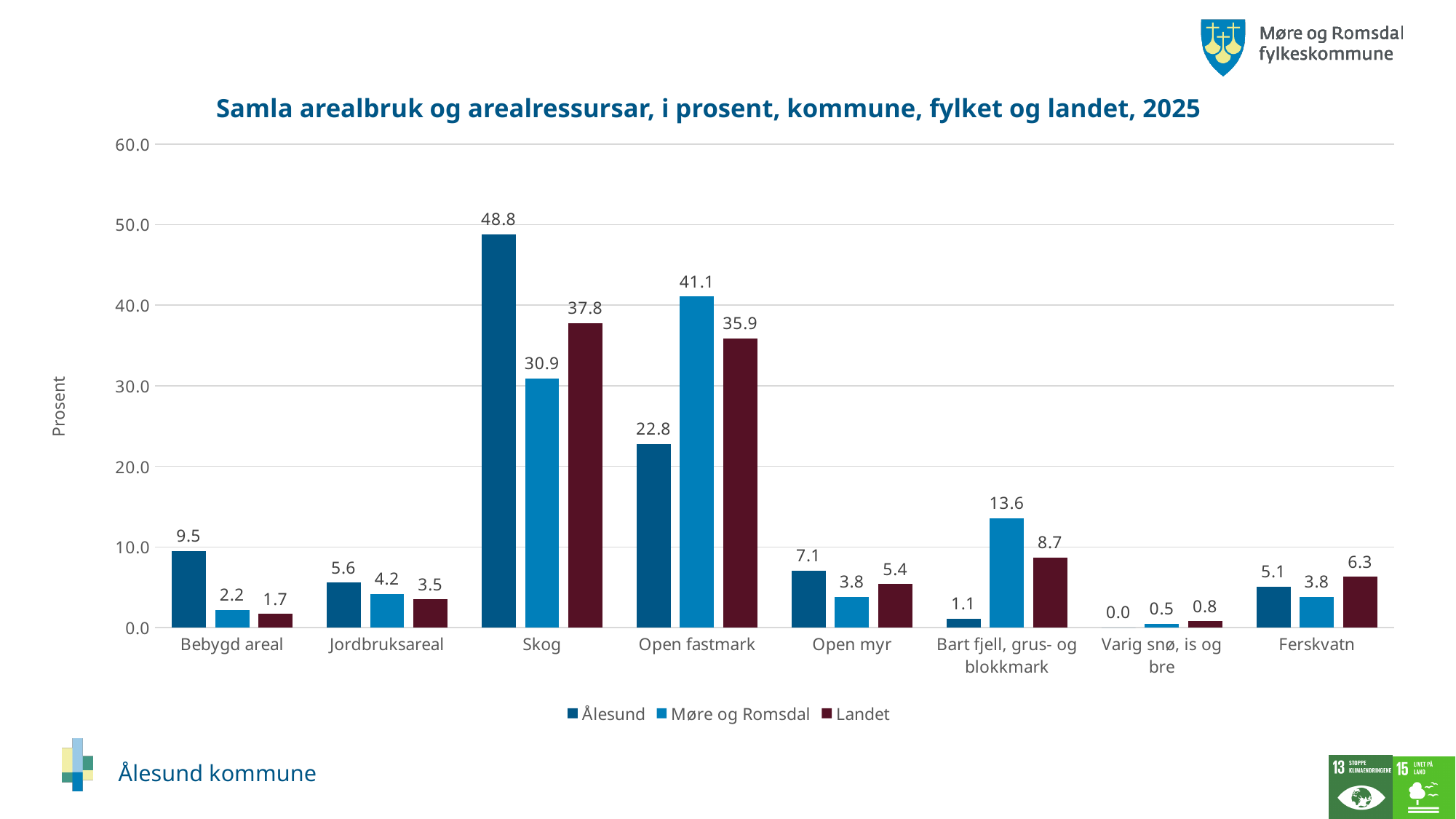
How many series does the legend list? 3 Is the value for Ålesund in Open fastmark greater or less than 20.0? greater What is the difference between the Ålesund and Landet values for Skog? 11.0 Which is larger in the Bart fjell, grus- og blokkmark category: Møre og Romsdal or Landet? Møre og Romsdal How many categories are shown on the x axis? 8 Which category has the highest value for Ålesund? Skog What is the value for Ålesund in the Skog category? 48.8 What is the value for Møre og Romsdal in the Open fastmark category? 41.1 What kind of chart is shown on the slide? Bar chart Which category has the lowest value for Møre og Romsdal? Varig snø, is og bre What is the label of the y axis? Prosent What is the value for Landet in the Ferskvatn category? 6.3